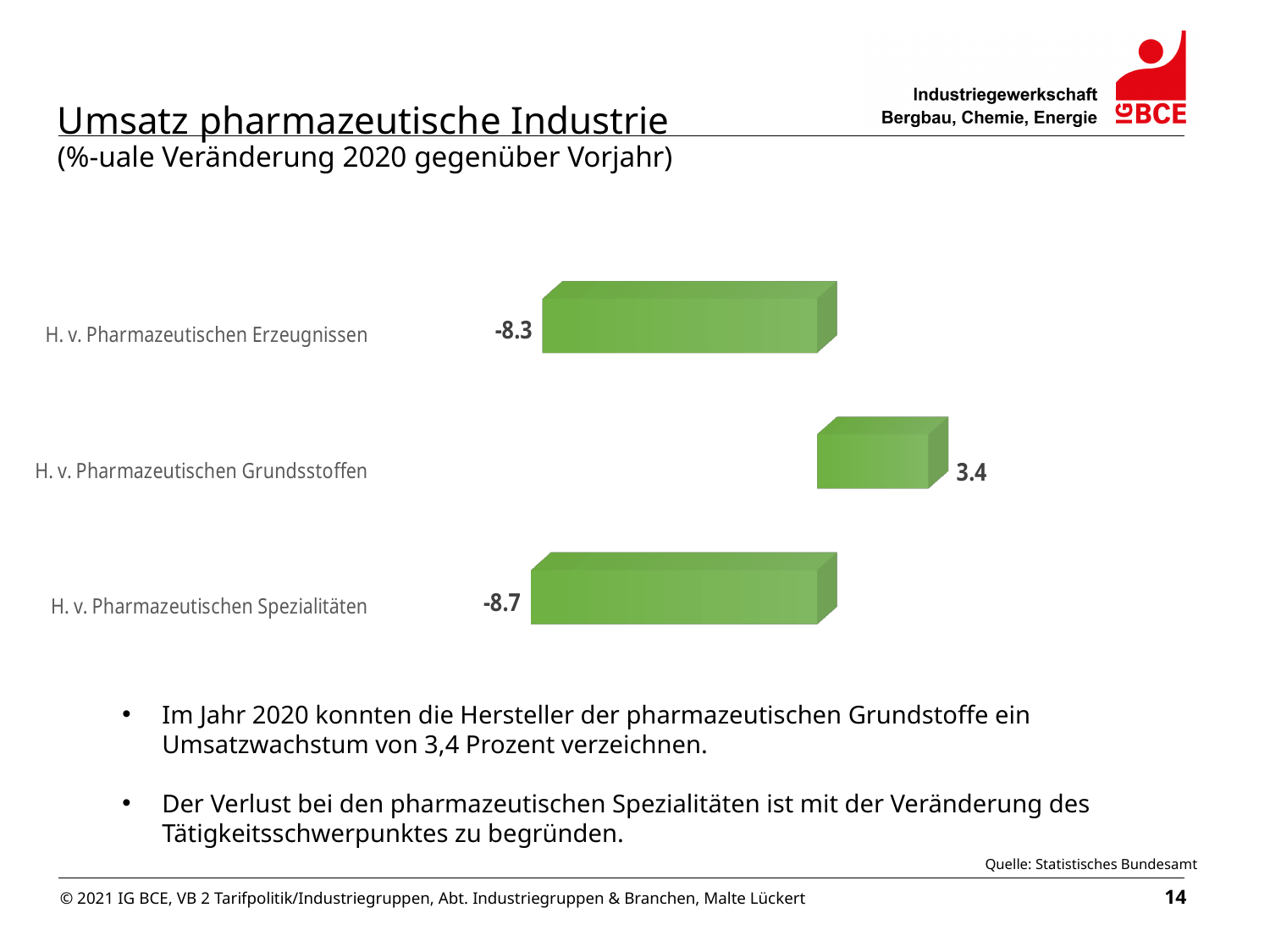
How many categories are shown in the chart? 3 What is the title of the chart on the slide? Umsatz pharmazeutische Industrie What is the difference between the values for H. v. Pharmazeutischen Grundsstoffen and H. v. Pharmazeutischen Erzeugnissen? 11.7 What is the value for H. v. Pharmazeutischen Erzeugnissen? -8.3 What kind of chart is shown on the slide? Bar chart How many categories in the chart have a negative value? 2 Which category has the highest value? H. v. Pharmazeutischen Grundsstoffen What is the value for H. v. Pharmazeutischen Spezialitäten? -8.7 What is the value for H. v. Pharmazeutischen Grundsstoffen? 3.4 Which category has the lowest value? H. v. Pharmazeutischen Spezialitäten What is the difference between the values for H. v. Pharmazeutischen Erzeugnissen and H. v. Pharmazeutischen Spezialitäten? 0.4 Which is larger, the value for H. v. Pharmazeutischen Erzeugnissen or the value for H. v. Pharmazeutischen Spezialitäten? H. v. Pharmazeutischen Erzeugnissen